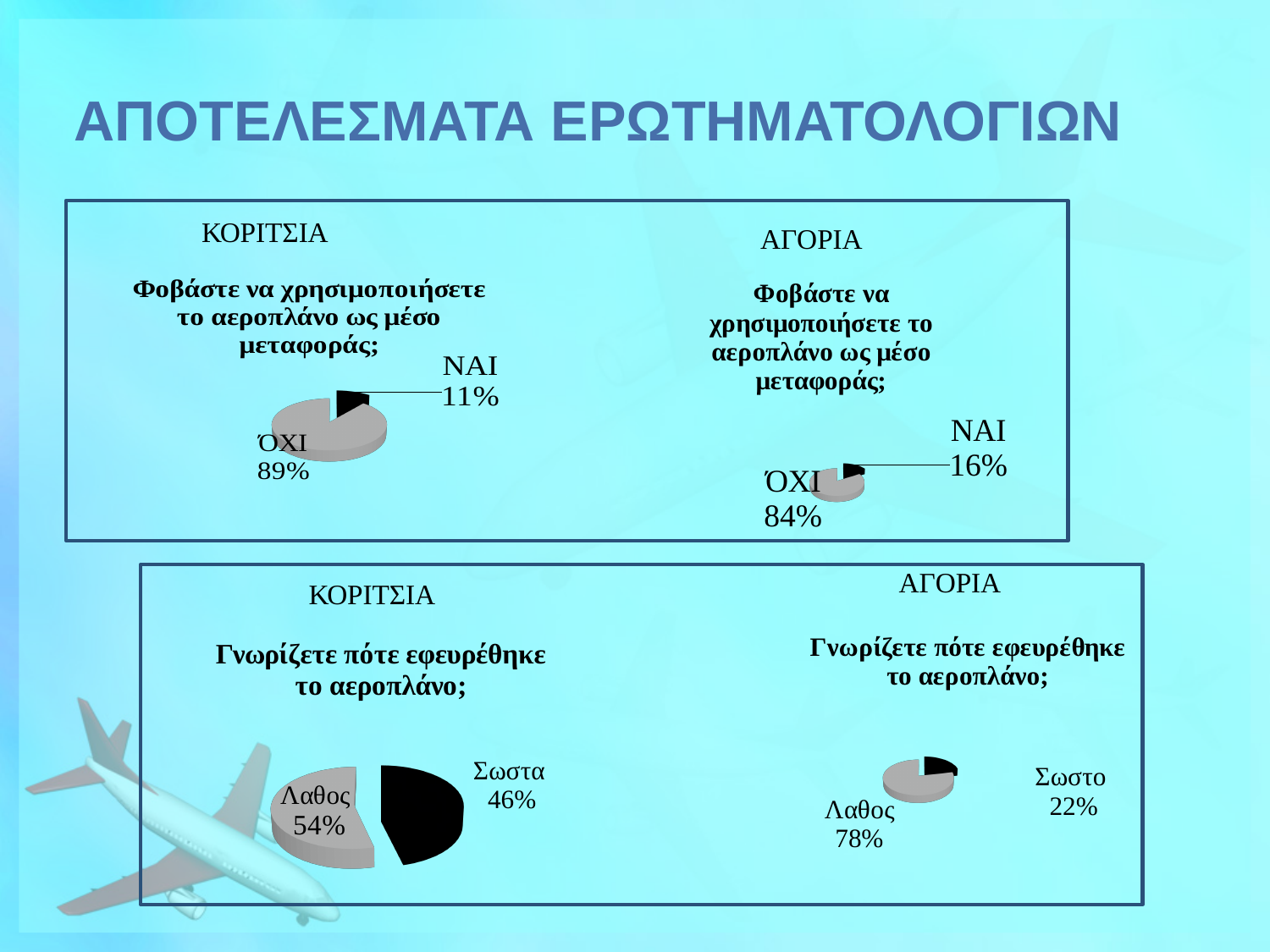
In the bottom-left pie chart (ΚΟΡΙΤΣΙΑ, when the airplane was invented), which slice is larger, Λαθος or Σωστα? Λαθος In the top-left pie chart (ΚΟΡΙΤΣΙΑ, fear of using the airplane), what percentage answered ΝΑΙ? 11% In the top-right pie chart (ΑΓΟΡΙΑ, fear of using the airplane), what percentage answered ΌΧΙ? 84% Which is larger: the ΝΑΙ share in the top-left pie chart (ΚΟΡΙΤΣΙΑ) or the ΝΑΙ share in the top-right pie chart (ΑΓΟΡΙΑ)? ΑΓΟΡΙΑ (16%) In the bottom-right pie chart (ΑΓΟΡΙΑ, when the airplane was invented), what percentage is labelled Σωστο? 22% How many slices does the bottom-right pie chart (ΑΓΟΡΙΑ, when the airplane was invented) have? 2 In the top-left pie chart (ΚΟΡΙΤΣΙΑ, fear of using the airplane), what percentage answered ΌΧΙ? 89% In the bottom-left pie chart (ΚΟΡΙΤΣΙΑ, when the airplane was invented), what percentage is labelled Λαθος? 54% What is the difference between the ΌΧΙ share in the top-left pie chart (ΚΟΡΙΤΣΙΑ) and the ΌΧΙ share in the top-right pie chart (ΑΓΟΡΙΑ)? 5% In the bottom-right pie chart (ΑΓΟΡΙΑ, when the airplane was invented), which slice is the smallest? Σωστο In the top-right pie chart (ΑΓΟΡΙΑ, fear of using the airplane), what percentage answered ΝΑΙ? 16% What type of chart is used in the bottom-left chart (ΚΟΡΙΤΣΙΑ, when the airplane was invented)? Pie chart